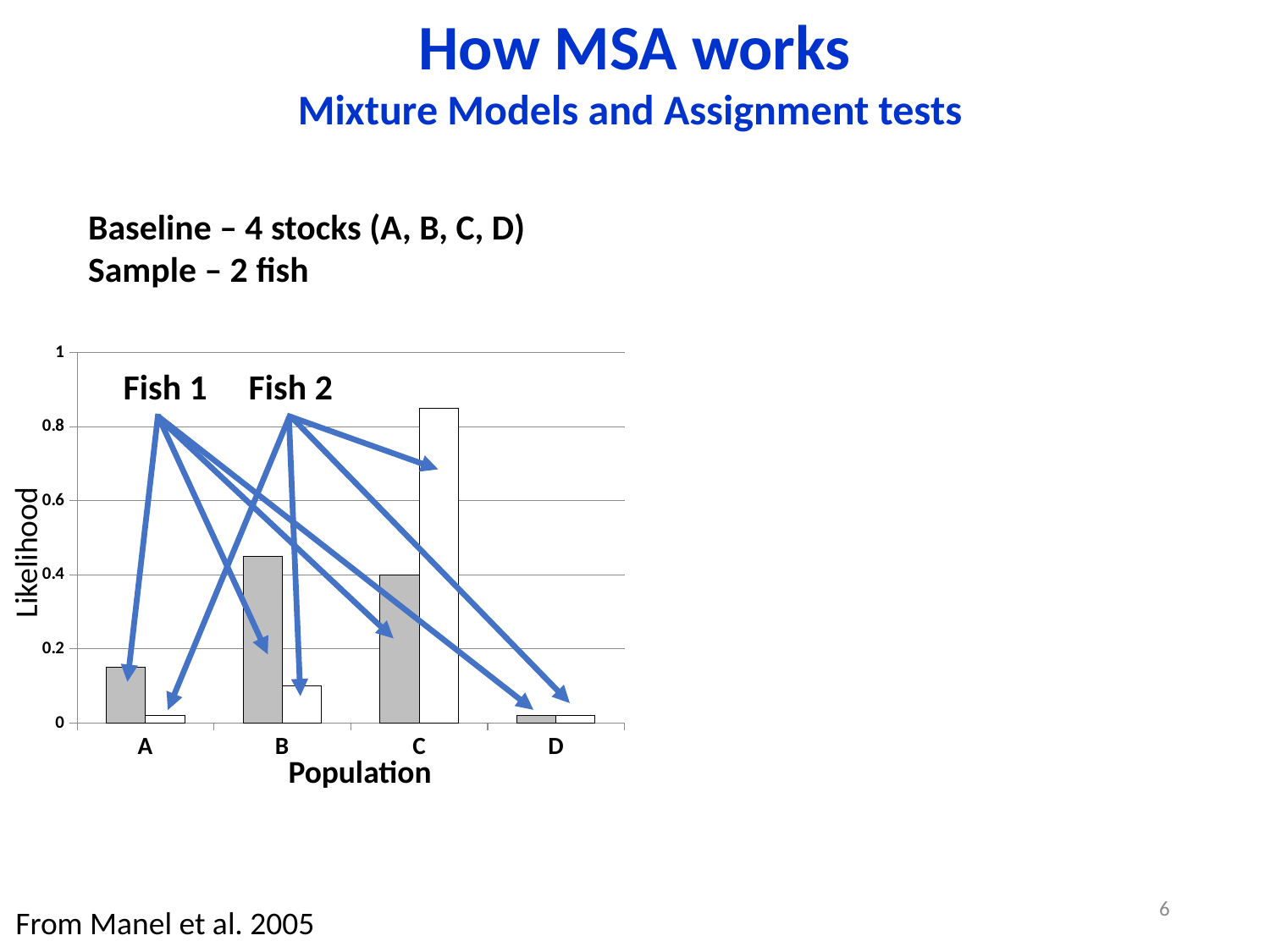
For which population is the likelihood for Fish 1 lowest? D What kind of chart is shown on the slide? bar chart At population B, which fish has the higher likelihood, Fish 1 or Fish 2? Fish 1 What is the label of the y axis of the chart? Likelihood Is the likelihood for Fish 2 at population C greater or less than 0.8? greater How many populations are shown on the x axis of the chart? 4 How many fish (series) are plotted in the chart? 2 Is the likelihood for Fish 2 at population B greater or less than 0.2? less At population C, which fish has the higher likelihood, Fish 1 or Fish 2? Fish 2 For which population is the likelihood for Fish 2 highest? C What is the label of the x axis of the chart? Population Is the likelihood for Fish 1 at population A greater or less than 0.2? less